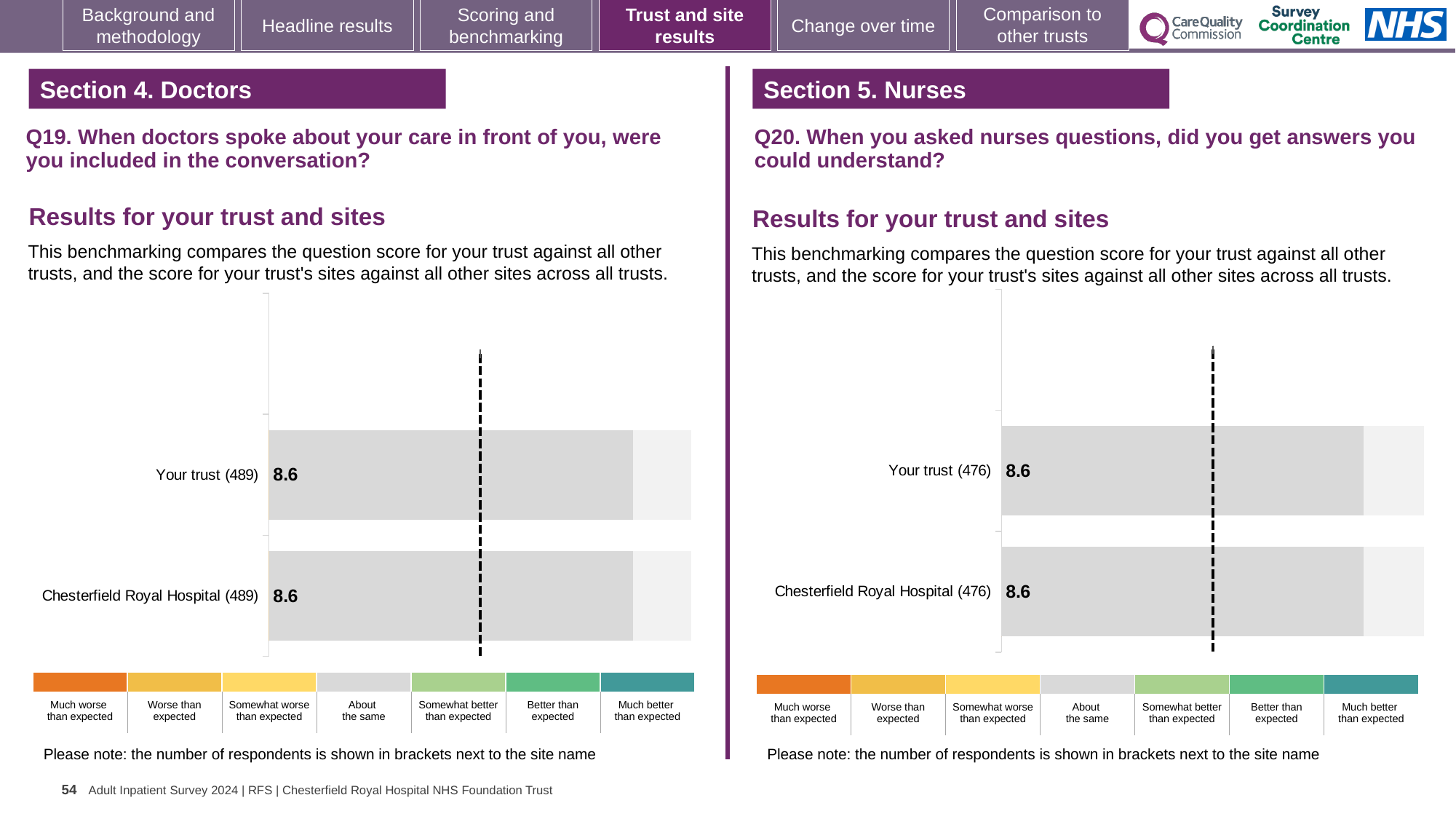
On the Q20 chart (Section 5. Nurses), how many respondents are shown in brackets next to Chesterfield Royal Hospital? 476 How many bars are plotted on the Q19 chart (Section 4. Doctors)? 2 How many bars are plotted on the Q20 chart (Section 5. Nurses)? 2 On the Q19 chart (Section 4. Doctors), what is the score for Chesterfield Royal Hospital? 8.6 On the Q19 chart (Section 4. Doctors), what is the score for Your trust? 8.6 On the Q20 chart (Section 5. Nurses), what is the score for Your trust? 8.6 On the Q20 chart (Section 5. Nurses), what is the score for Chesterfield Royal Hospital? 8.6 Is the score for Your trust on the Q20 chart (Section 5. Nurses) larger than, smaller than, or equal to the score for Your trust on the Q19 chart (Section 4. Doctors)? Equal What kind of chart is used on the Q19 chart (Section 4. Doctors)? Bar chart On the Q20 chart (Section 5. Nurses), what is the difference between the score for Your trust and the score for Chesterfield Royal Hospital? 0 On the Q19 chart (Section 4. Doctors), how many respondents are shown in brackets next to Your trust? 489 On the Q19 chart (Section 4. Doctors), what is the difference between the score for Your trust and the score for Chesterfield Royal Hospital? 0